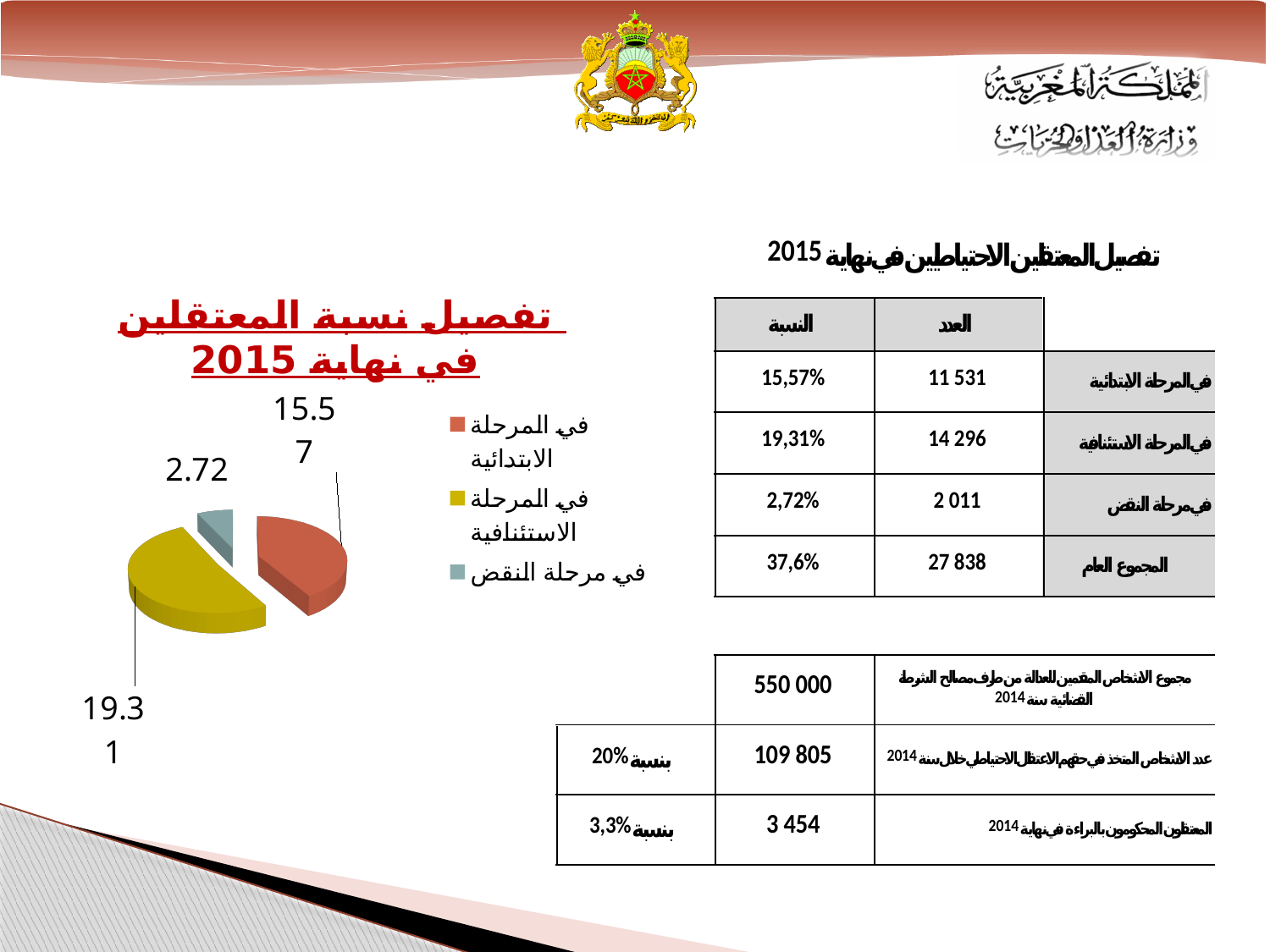
What is the value shown for في المرحلة الاستئنافية in the pie chart? 19.31 How many slices does the pie chart have? 3 Which category has the smallest slice in the pie chart? في مرحلة النقض What is the difference between the values for في المرحلة الاستئنافية and في المرحلة الابتدائية in the pie chart? 3.74 What is the value shown for في مرحلة النقض in the pie chart? 2.72 What kind of chart is shown on the slide? pie chart What is the difference between the values for في المرحلة الابتدائية and في مرحلة النقض in the pie chart? 12.85 How many entries does the legend of the pie chart list? 3 What is the value shown for في المرحلة الابتدائية in the pie chart? 15.57 Which is larger in the pie chart: في المرحلة الابتدائية or في المرحلة الاستئنافية? في المرحلة الاستئنافية What colour is the slice for في المرحلة الاستئنافية in the pie chart? yellow Which category has the largest slice in the pie chart? في المرحلة الاستئنافية